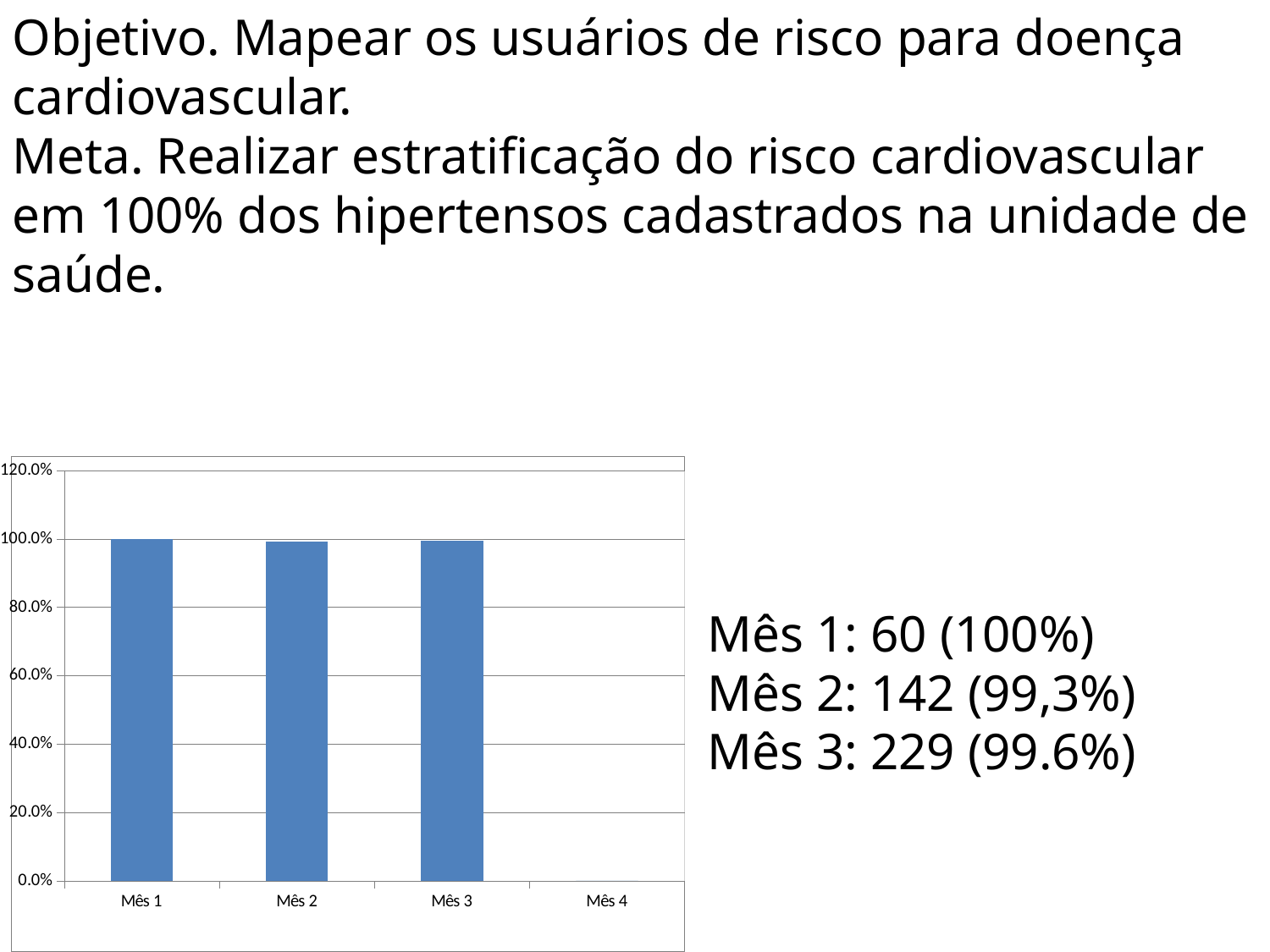
What is the highest value shown on the y axis of the chart? 120.0% What colour are the bars in the chart? blue Which category has the lowest value in the chart? Mês 4 Is the value for Mês 4 greater or less than 20.0%? less What kind of chart is shown on the slide? bar chart Which is larger, the value for Mês 1 or the value for Mês 4? Mês 1 Is the value for Mês 2 greater or less than 80.0%? greater Which is larger, the value for Mês 3 or the value for Mês 4? Mês 3 What is the value for Mês 1 in the chart? 100.0% How many categories are shown on the x axis of the chart? 4 Is the value for Mês 3 greater or less than 60.0%? greater